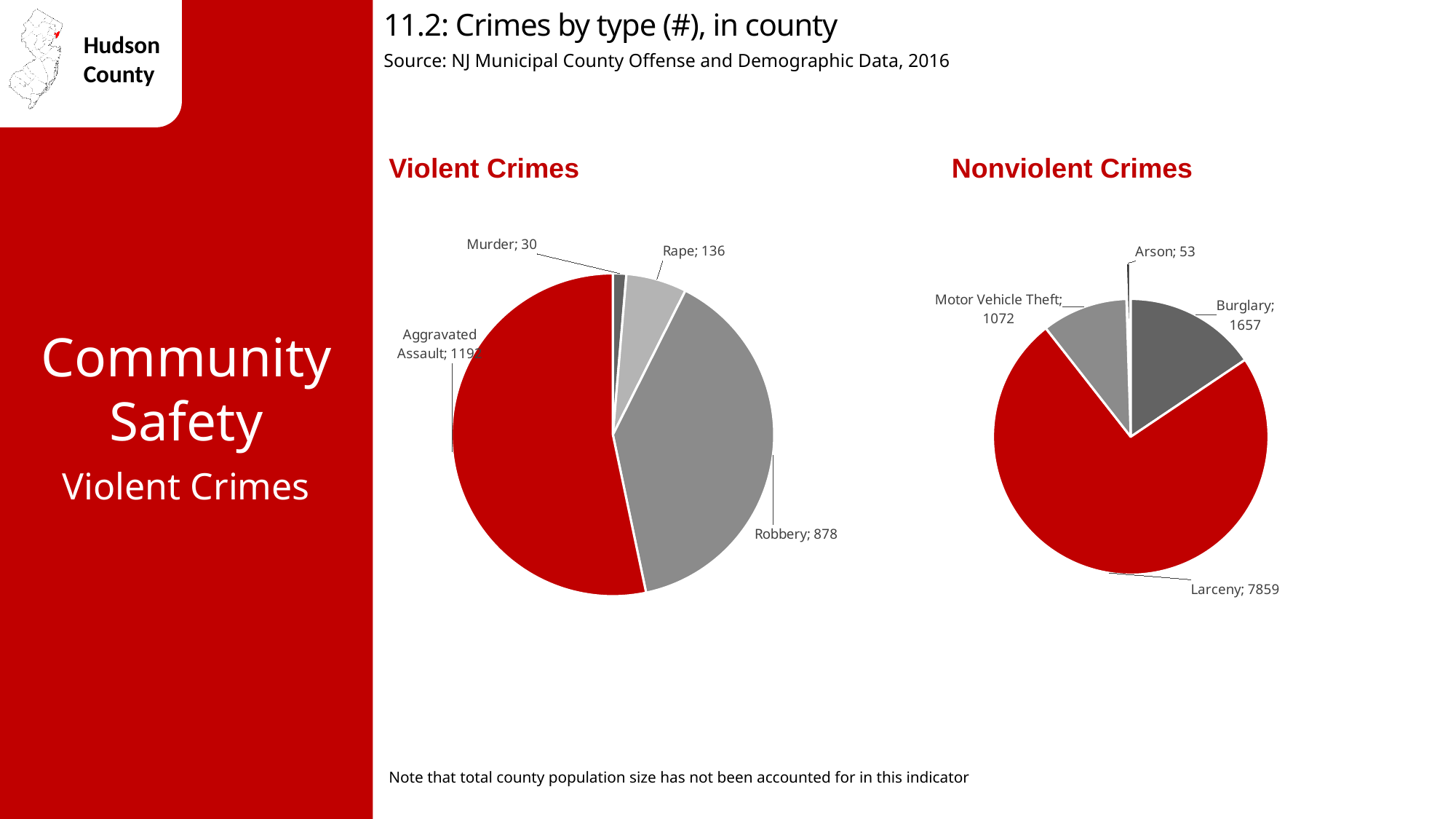
In the Violent Crimes pie chart, which crime type has the smallest slice? Murder In the Nonviolent Crimes pie chart, what is the difference between Burglary and Motor Vehicle Theft? 585 In the Nonviolent Crimes pie chart, what is the value for Motor Vehicle Theft? 1072 How many crime types are shown in the Nonviolent Crimes pie chart? 4 In the Violent Crimes pie chart, what is the value for Rape? 136 In the Violent Crimes pie chart, what is the value for Robbery? 878 In the Nonviolent Crimes pie chart, what is the value for Larceny? 7859 In the Nonviolent Crimes pie chart, which crime type has the smallest slice? Arson In the Violent Crimes pie chart, how many murders are shown? 30 In the Violent Crimes pie chart, which is larger, Robbery or Rape? Robbery In the Nonviolent Crimes pie chart, what is the value for Burglary? 1657 In the Nonviolent Crimes pie chart, which crime type has the largest slice? Larceny